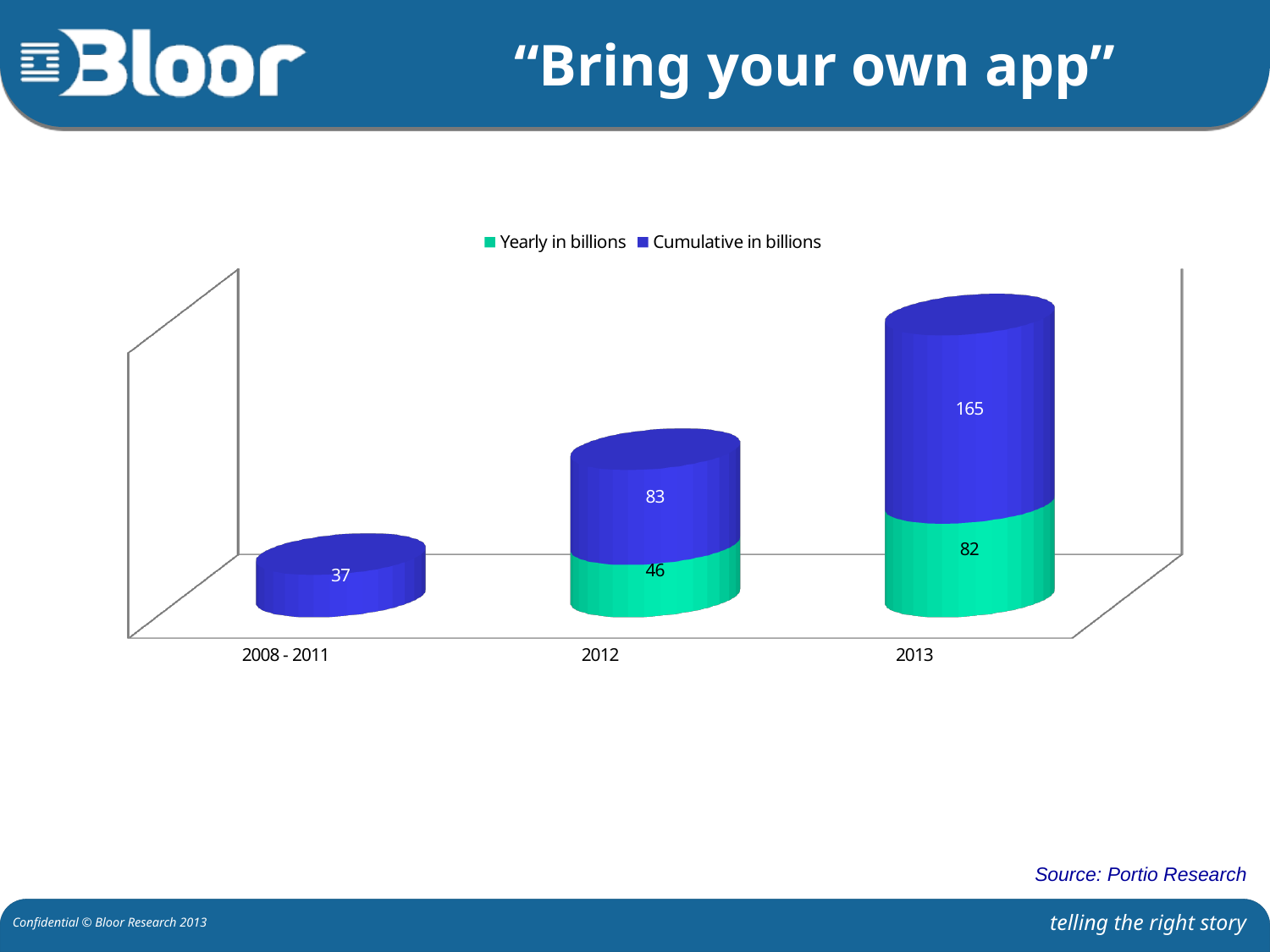
Which is larger: the Yearly in billions value for 2013 or the Cumulative in billions value for 2012? Cumulative in billions for 2012 What kind of chart is shown on the slide? Stacked bar chart How many categories are shown on the x axis? 3 What is the Yearly in billions value for 2012? 46 What is the difference between the Cumulative in billions values for 2013 and 2012? 82 How many series does the legend list? 2 Which category has the highest Cumulative in billions value? 2013 What is the Cumulative in billions value for 2013? 165 What is the Yearly in billions value for 2013? 82 What is the Cumulative in billions value for 2012? 83 What is the Cumulative in billions value for 2008 - 2011? 37 Which category has the lowest Cumulative in billions value? 2008 - 2011